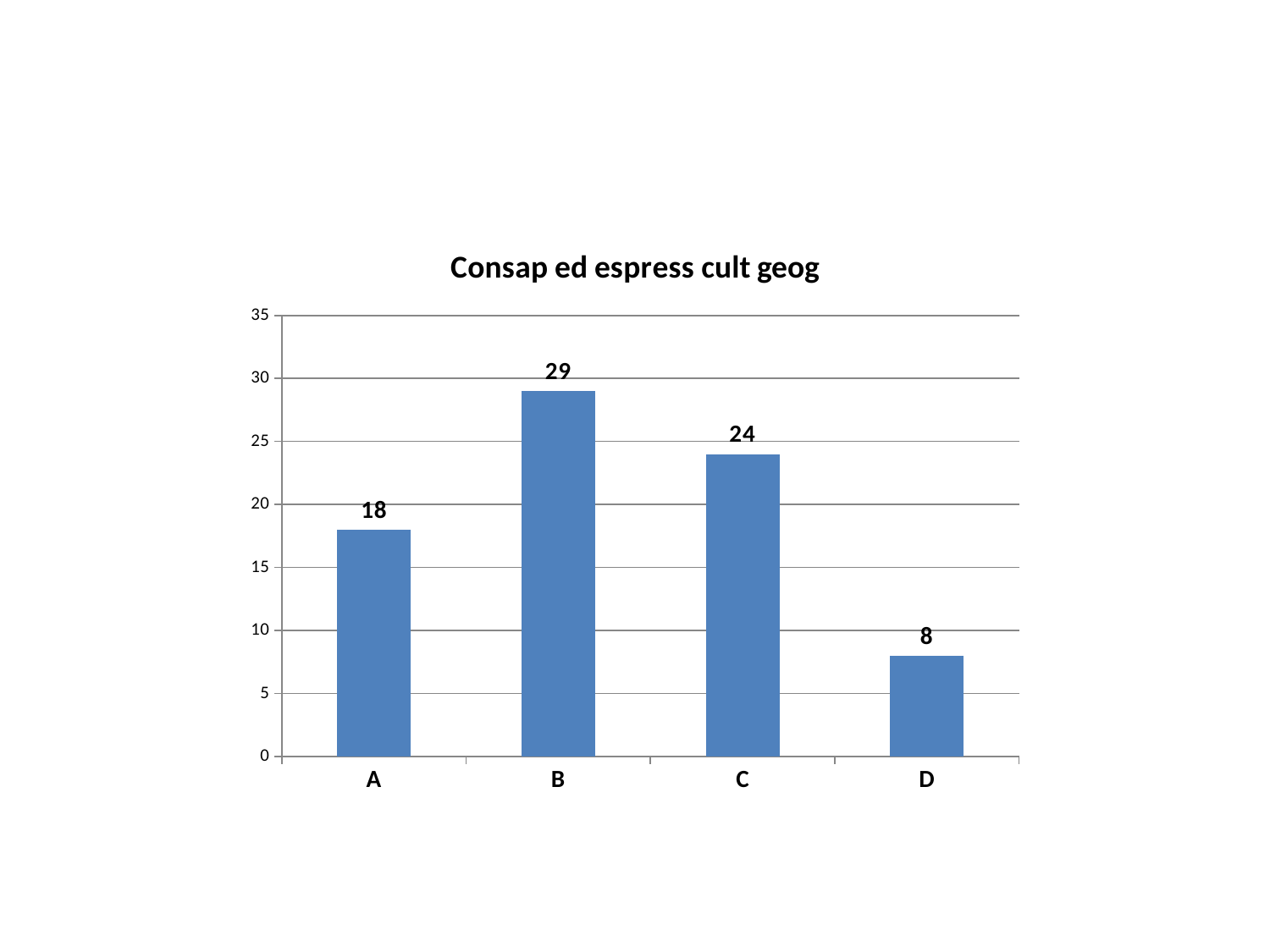
What is the value for category C? 24 Which category has the lowest value? D What is the difference between the values for B and C? 5 How many categories are shown on the x axis? 4 Which category has the highest value? B What is the value for category B? 29 What is the difference between the values for A and D? 10 What is the value for category A? 18 What kind of chart is shown on the slide? Bar chart Which is larger, the value for A or the value for C? C What is the value for category D? 8 What is the title of the chart? Consap ed espress cult geog